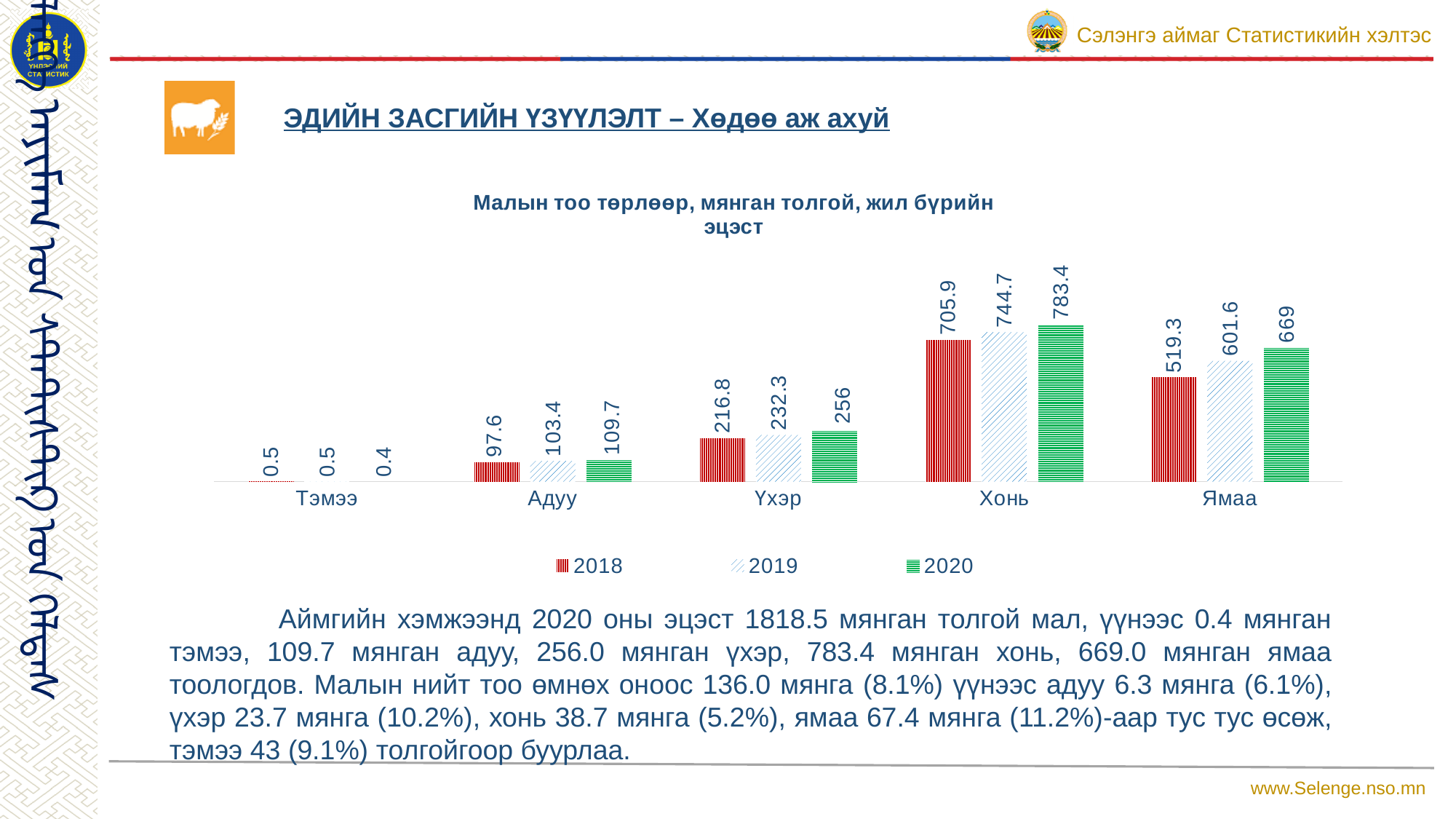
How many categories are shown on the x axis? 5 What is the value for Адуу in 2018? 97.6 Which is larger: the 2020 value for Үхэр or the 2020 value for Адуу? Үхэр What is the value for Хонь in 2020? 783.4 Which category has the highest value in 2020? Хонь What is the difference between the 2020 and 2018 values for Ямаа? 149.7 What is the difference between the 2019 and 2018 values for Үхэр? 15.5 What is the value for Ямаа in 2019? 601.6 What is the value for Тэмээ in 2020? 0.4 How many series does the legend list? 3 Do the values for Хонь rise or fall from 2018 to 2020? rise Which category has the lowest value in 2018? Тэмээ